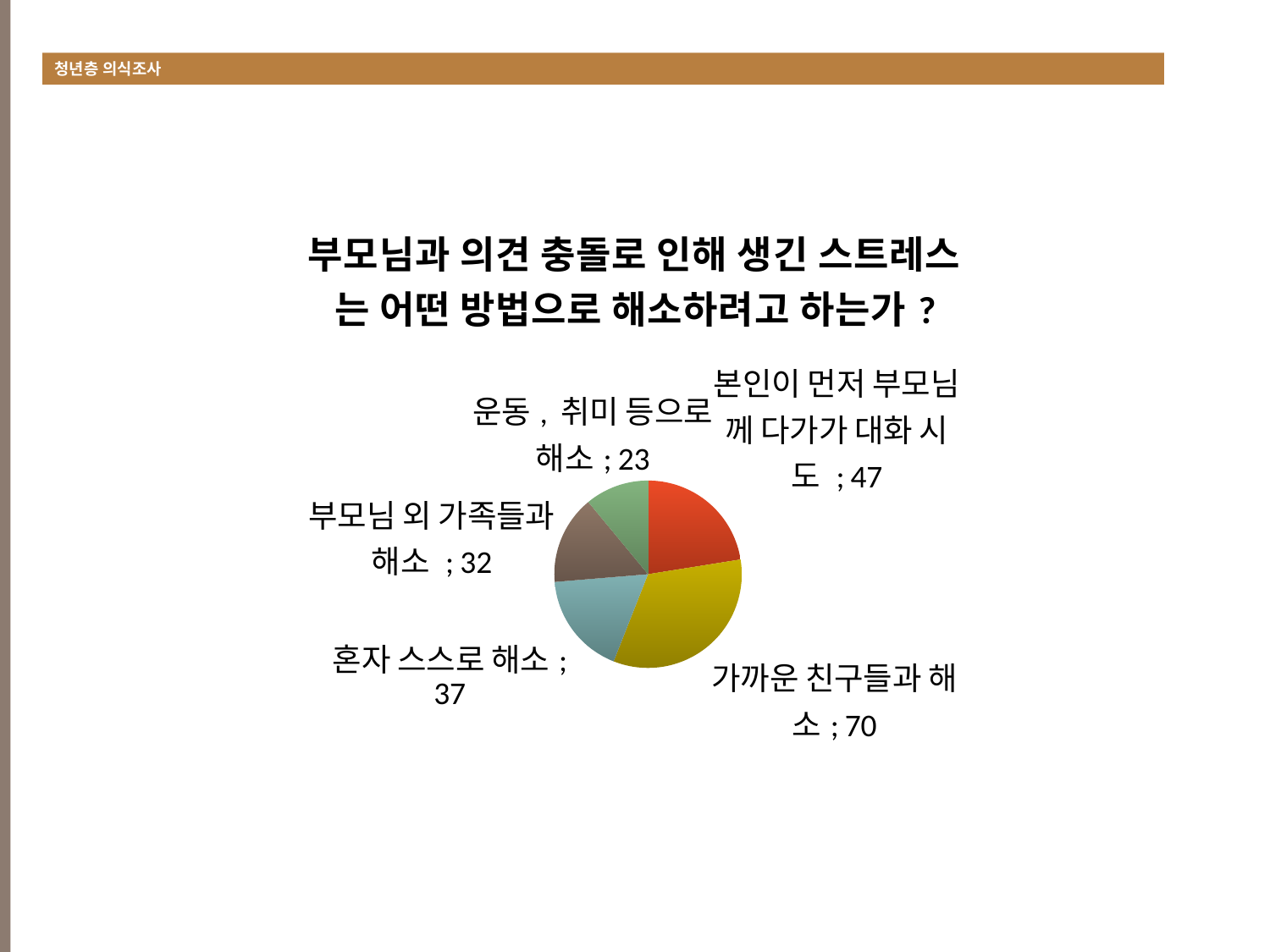
What is the value for 혼자 스스로 해소? 37 What is the value for 가까운 친구들과 해소? 70 How many categories does the pie chart have? 5 What is the value for 운동, 취미 등으로 해소? 23 What is the difference between the values for 가까운 친구들과 해소 and 본인이 먼저 부모님께 다가가 대화 시도? 23 What kind of chart is shown on the slide? pie chart Which category has the smallest slice? 운동, 취미 등으로 해소 What is the value for 본인이 먼저 부모님께 다가가 대화 시도? 47 What is the title of the chart? 부모님과 의견 충돌로 인해 생긴 스트레스는 어떤 방법으로 해소하려고 하는가? What is the value for 부모님 외 가족들과 해소? 32 Which is larger, 혼자 스스로 해소 or 부모님 외 가족들과 해소? 혼자 스스로 해소 Which category has the largest slice? 가까운 친구들과 해소